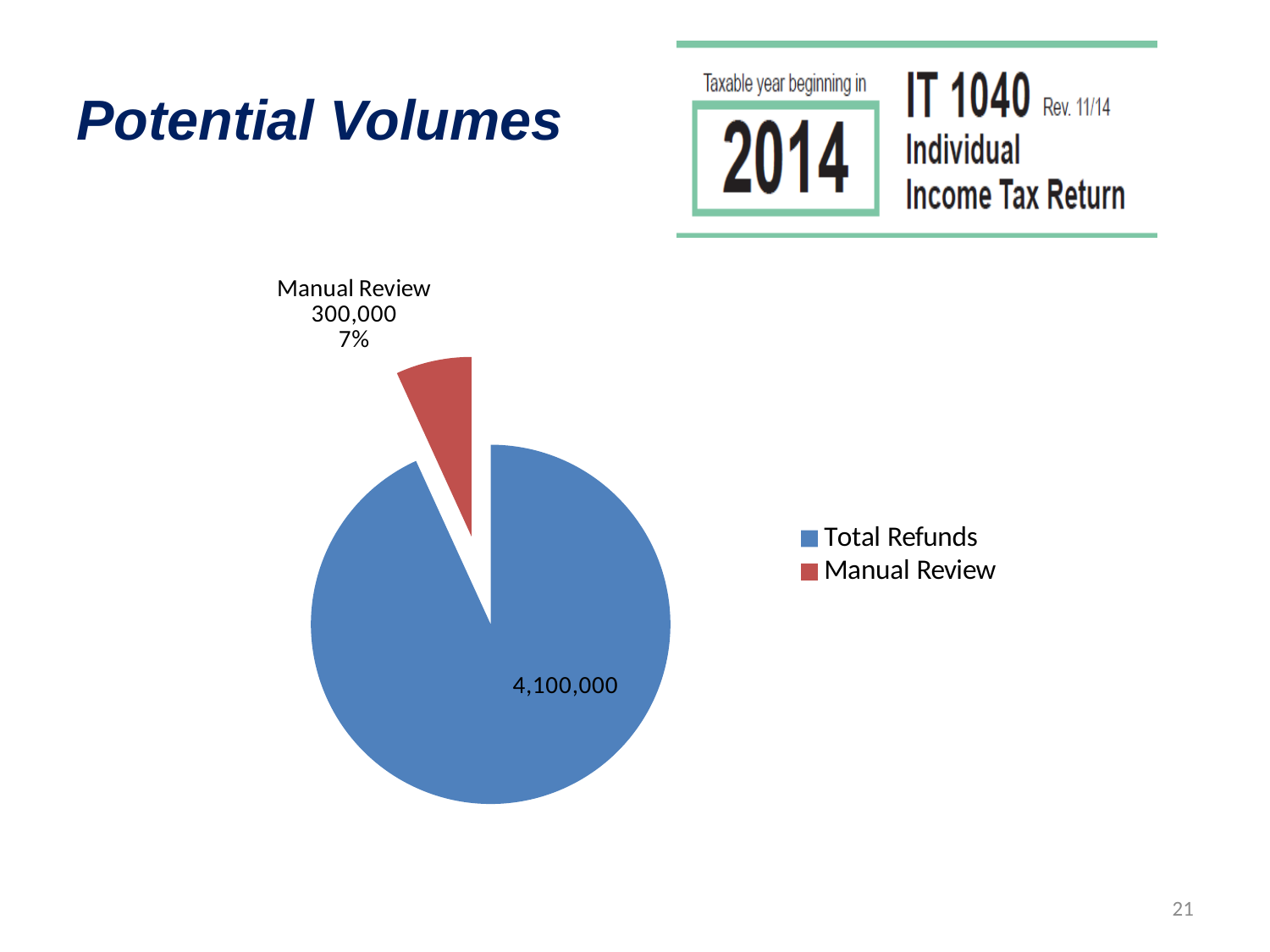
Which slice of the pie chart is the smallest? Manual Review How many slices does the pie chart have? 2 What type of chart is shown on the slide? Pie chart Which slice of the pie chart is the largest? Total Refunds What is the combined total of the Total Refunds and Manual Review values? 4,400,000 Which is larger, Total Refunds or Manual Review? Total Refunds What colour is the Manual Review slice in the pie chart? Red How many entries does the chart legend list? 2 What value is shown for the Manual Review slice of the pie chart? 300,000 What percentage of the pie does the Manual Review slice represent? 7% What is the difference between the Total Refunds value and the Manual Review value? 3,800,000 What value is shown for the Total Refunds slice of the pie chart? 4,100,000